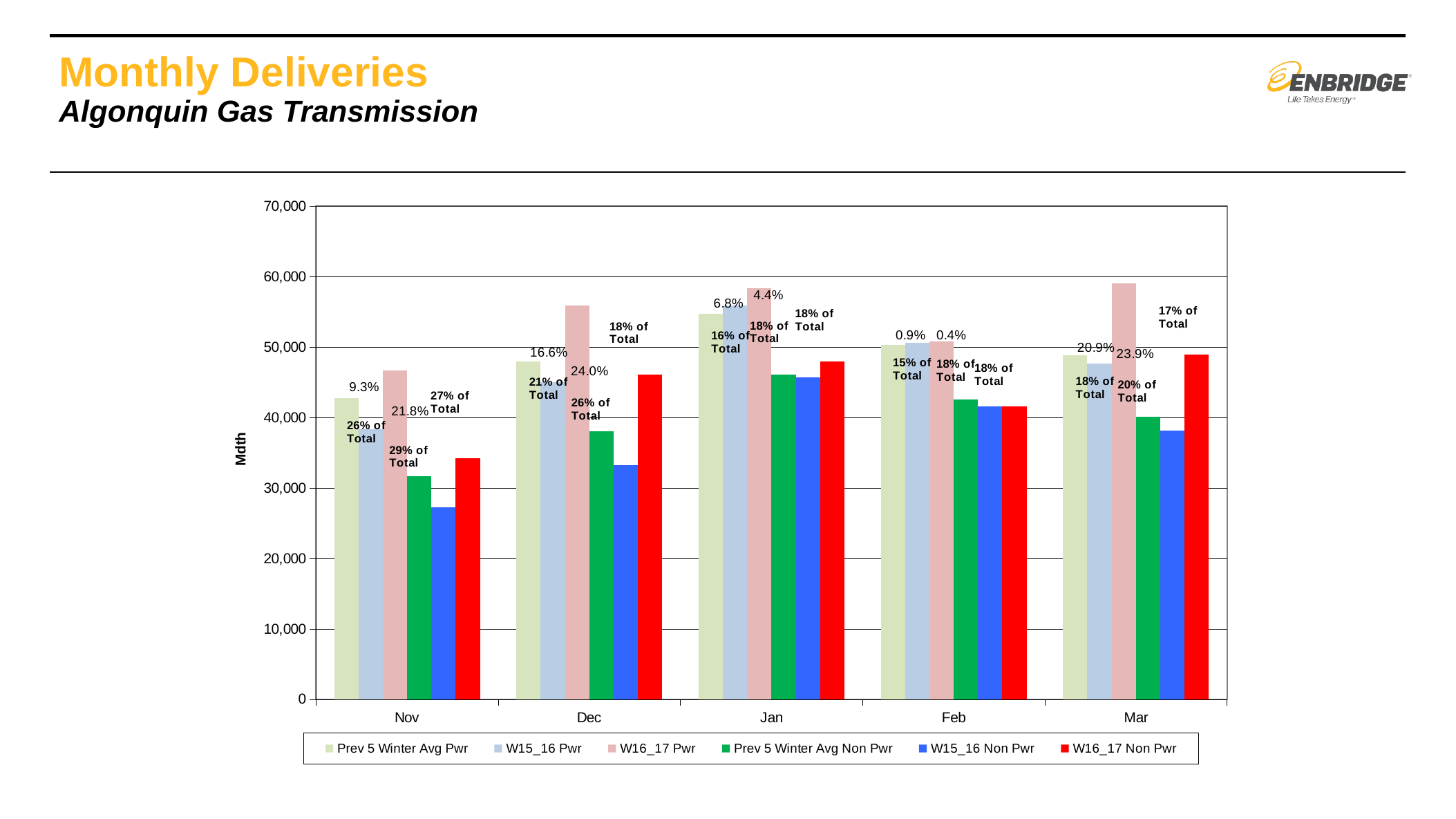
Is the value for W16_17 Pwr in Dec greater or less than 50,000? greater In Nov, which is larger: W16_17 Pwr or Prev 5 Winter Avg Pwr? W16_17 Pwr Is the value for Prev 5 Winter Avg Non Pwr in Jan greater or less than 40,000? greater Which month has the lowest value for Prev 5 Winter Avg Pwr? Nov In Dec, which is larger: W16_17 Non Pwr or Prev 5 Winter Avg Non Pwr? W16_17 Non Pwr What kind of chart is shown on the slide? Bar chart Is the value for W15_16 Non Pwr in Nov greater or less than 30,000? less What is the label on the y axis? Mdth How many months are shown on the x axis? 5 Which series has the highest bar in Mar? W16_17 Pwr How many series does the legend list? 6 Which month has the lowest value for W15_16 Non Pwr? Nov